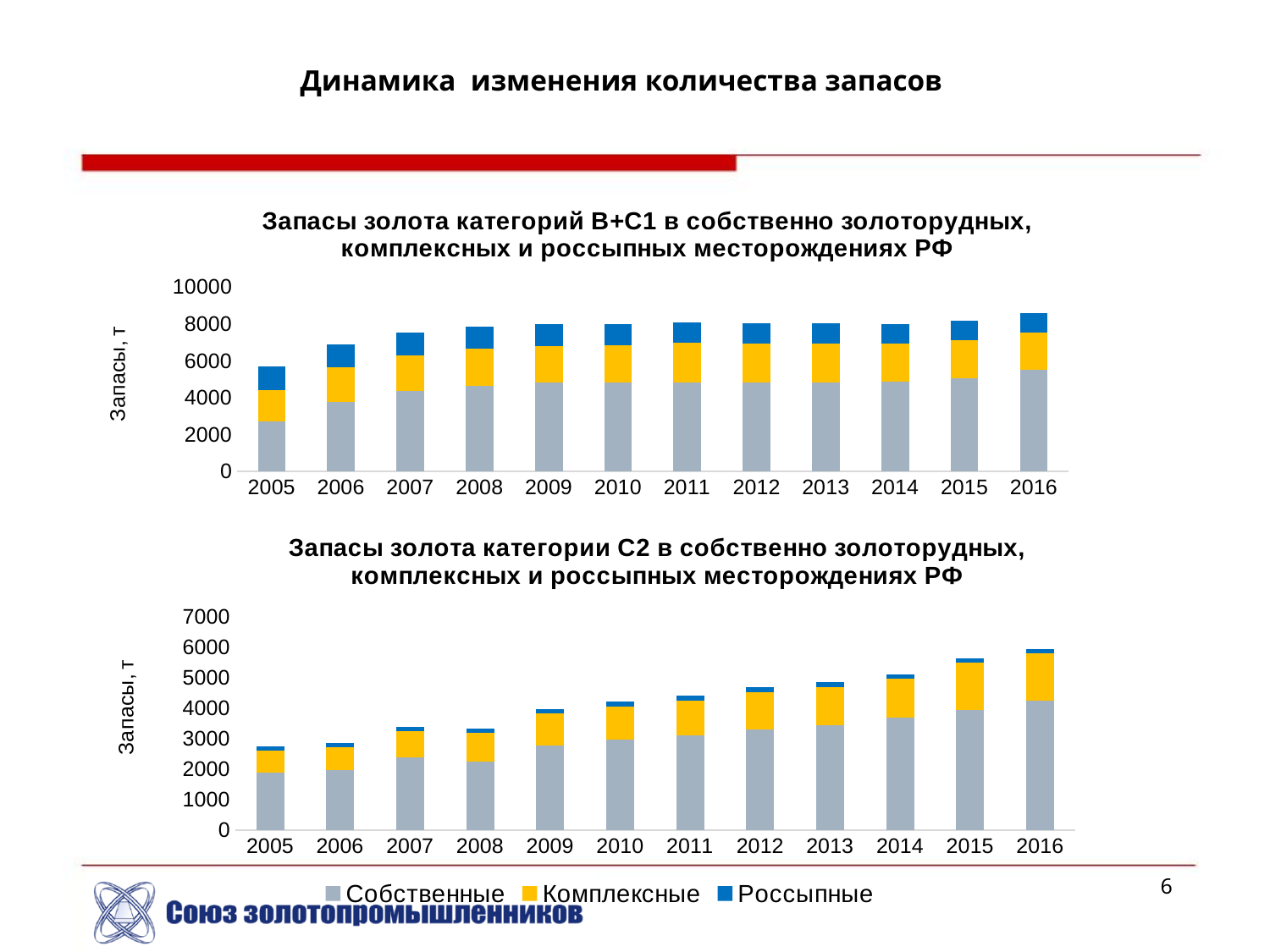
In the bottom chart (C2), do the total stacked values generally rise or fall from 2005 to 2016? rise In the bottom chart (C2), is the total for 2015 greater or less than 5000? greater In the top chart (B+C1), which year has the highest total stacked bar? 2016 How many series does the legend at the bottom of the slide list? 3 In the top chart (B+C1), which year has the lowest total stacked bar? 2005 In the top chart (B+C1), is the total for 2016 greater or less than 8000? greater In the top chart (B+C1), is the total for 2005 greater or less than 6000? less How many years are shown on the x axis of the bottom chart, 'Запасы золота категории C2 в собственно золоторудных, комплексных и россыпных месторождениях РФ'? 12 In the bottom chart (C2), which year has the highest total stacked bar? 2016 What kind of chart is the top chart, 'Запасы золота категорий B+C1 в собственно золоторудных, комплексных и россыпных месторождениях РФ'? Stacked bar chart What are the three series named in the legend? Собственные, Комплексные, Россыпные